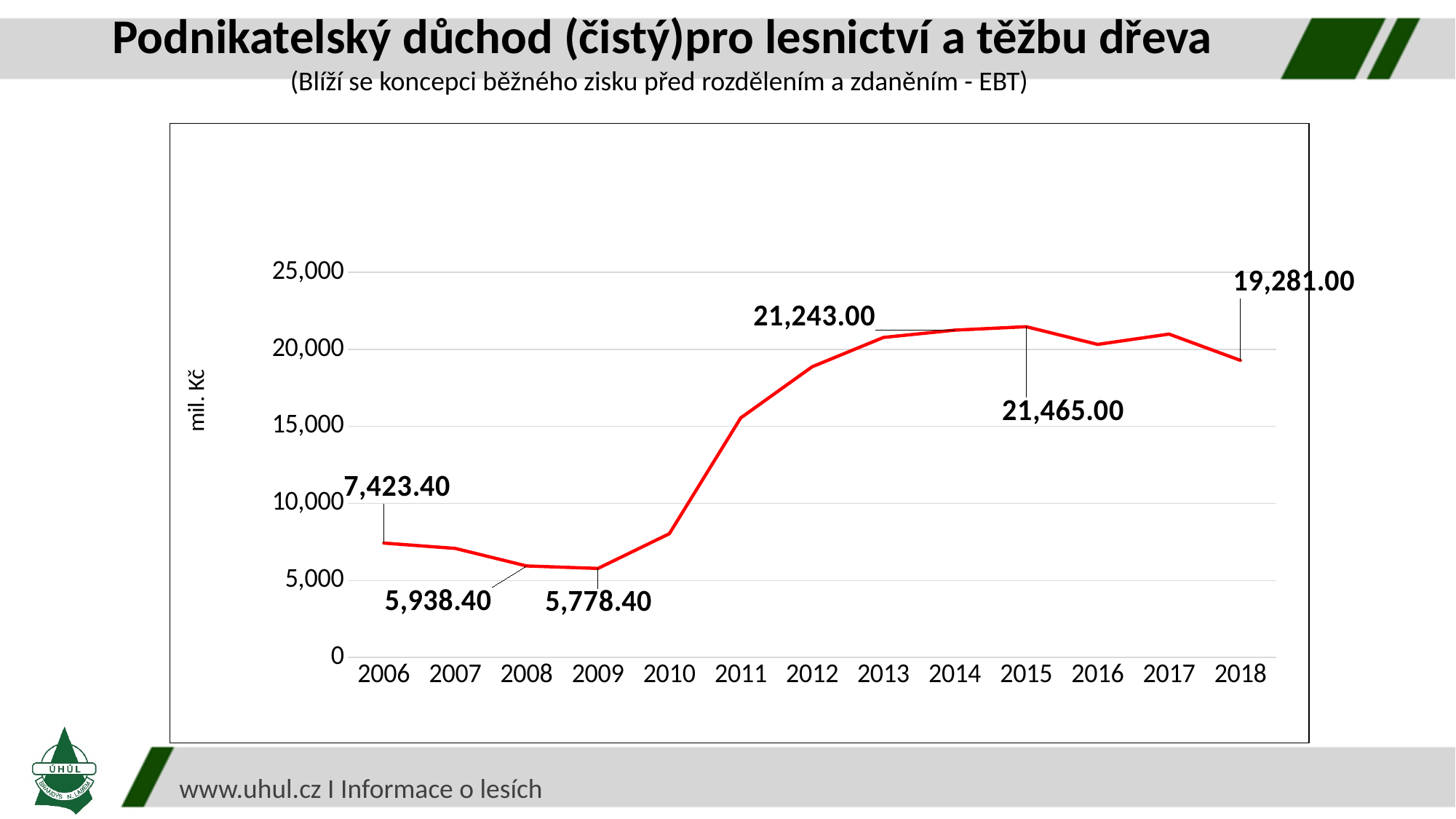
What is the value for 2015? 21,465.00 Which year has the highest value? 2015 What is the value for 2009? 5,778.40 How many years are plotted on the x axis? 13 Is the value for 2010 greater or less than 10,000? less What is the value for 2006? 7,423.40 Is the value for 2011 greater or less than 15,000? greater What is the value for 2018? 19,281.00 What is the difference between the values for 2008 and 2009? 160.00 Which year has the lowest value? 2009 What kind of chart is shown? line chart